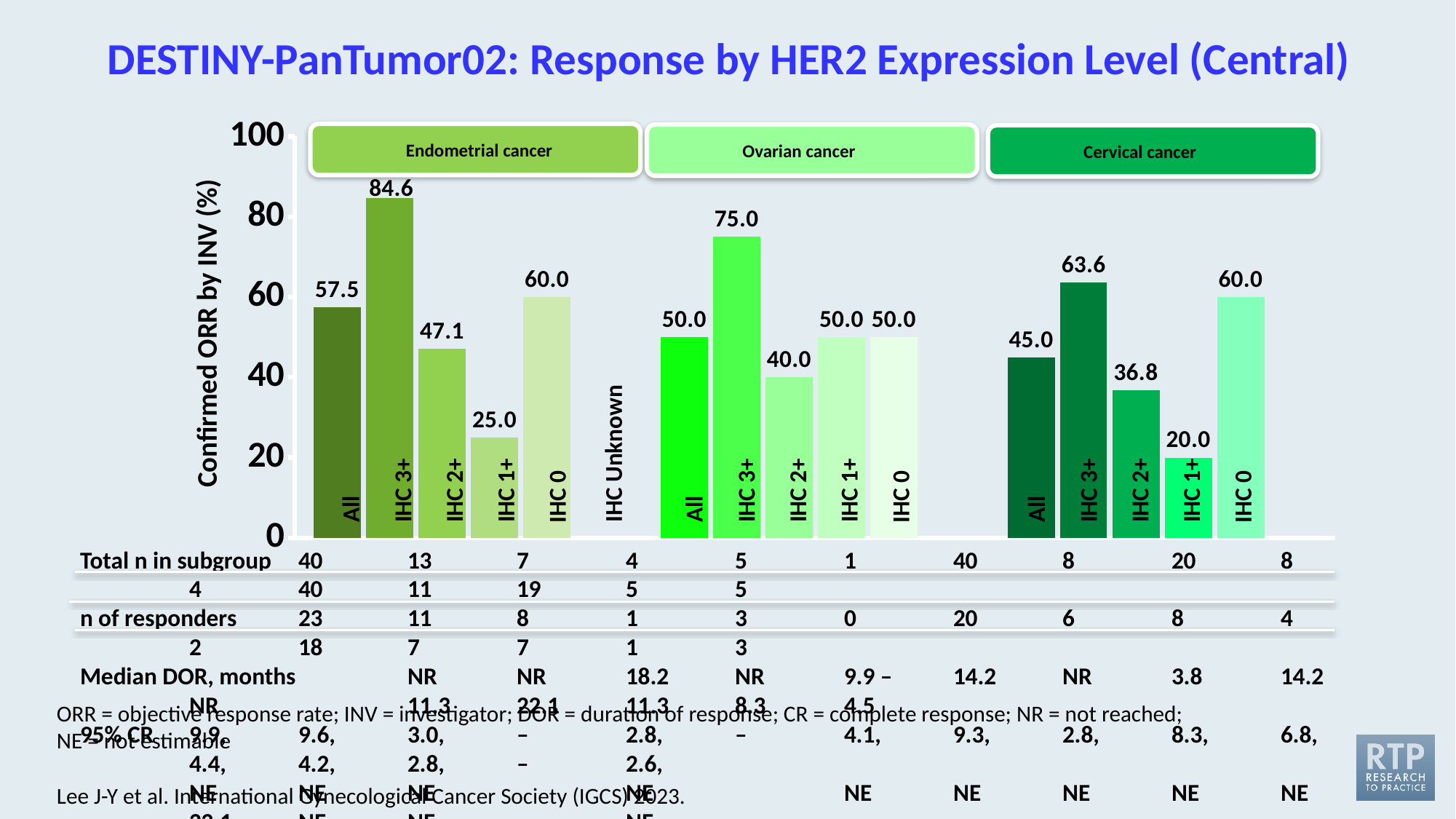
What is the label of the y-axis of the chart? Confirmed ORR by INV (%) What is the confirmed ORR for the All subgroup in the Ovarian cancer group? 50.0 What is the difference in confirmed ORR between IHC 3+ and IHC 1+ in the Endometrial cancer group? 59.6 What type of chart is shown on the slide? Bar chart How many cancer types are shown in the chart? 3 Is the confirmed ORR for IHC 3+ in the Cervical cancer group greater or less than 60? greater Which subgroup has the lowest confirmed ORR in the Cervical cancer group? IHC 1+ Which has a higher confirmed ORR: IHC 0 in the Endometrial cancer group or IHC 0 in the Ovarian cancer group? IHC 0 in the Endometrial cancer group What is the confirmed ORR for IHC 3+ in the Endometrial cancer group? 84.6 What is the difference in confirmed ORR between the All subgroup of the Endometrial cancer group and the All subgroup of the Cervical cancer group? 12.5 Which subgroup has the highest confirmed ORR in the Ovarian cancer group? IHC 3+ What is the confirmed ORR for IHC 2+ in the Cervical cancer group? 36.8